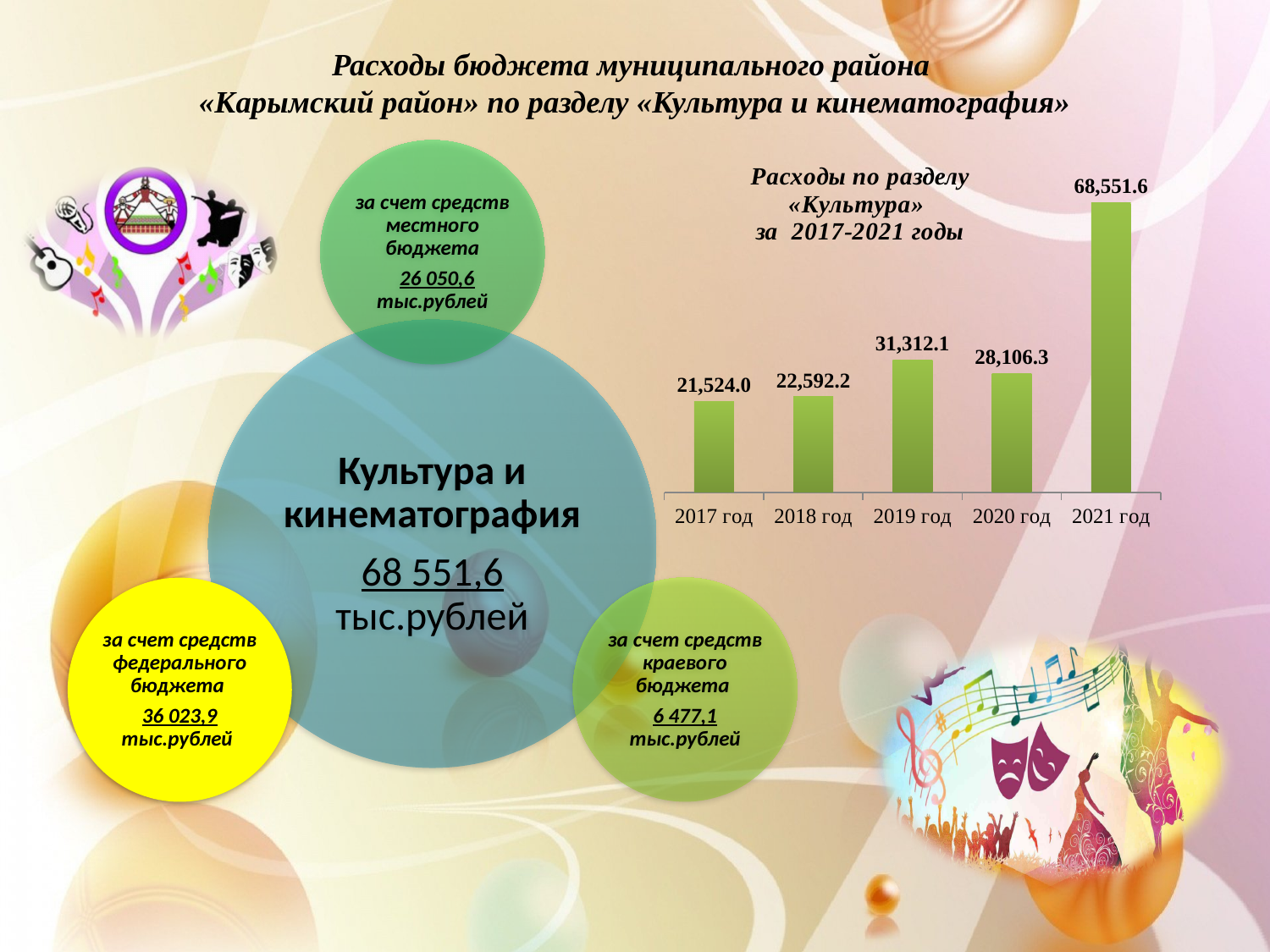
What is the value for 2021 год in the chart? 68,551.6 Which year has the highest value in the chart? 2021 год What is the value for 2017 год in the chart? 21,524.0 Which year has the lowest value in the chart? 2017 год What is the title of the chart? Расходы по разделу «Культура» за 2017-2021 годы What is the difference between the values for 2021 год and 2020 год? 40,445.3 Which is larger, the value for 2019 год or the value for 2020 год? 2019 год What is the value for 2019 год in the chart? 31,312.1 How many years are shown in the chart? 5 Does the value rise or fall from 2019 год to 2020 год? fall What is the difference between the values for 2019 год and 2018 год? 8,719.9 What kind of chart is shown on the slide? bar chart